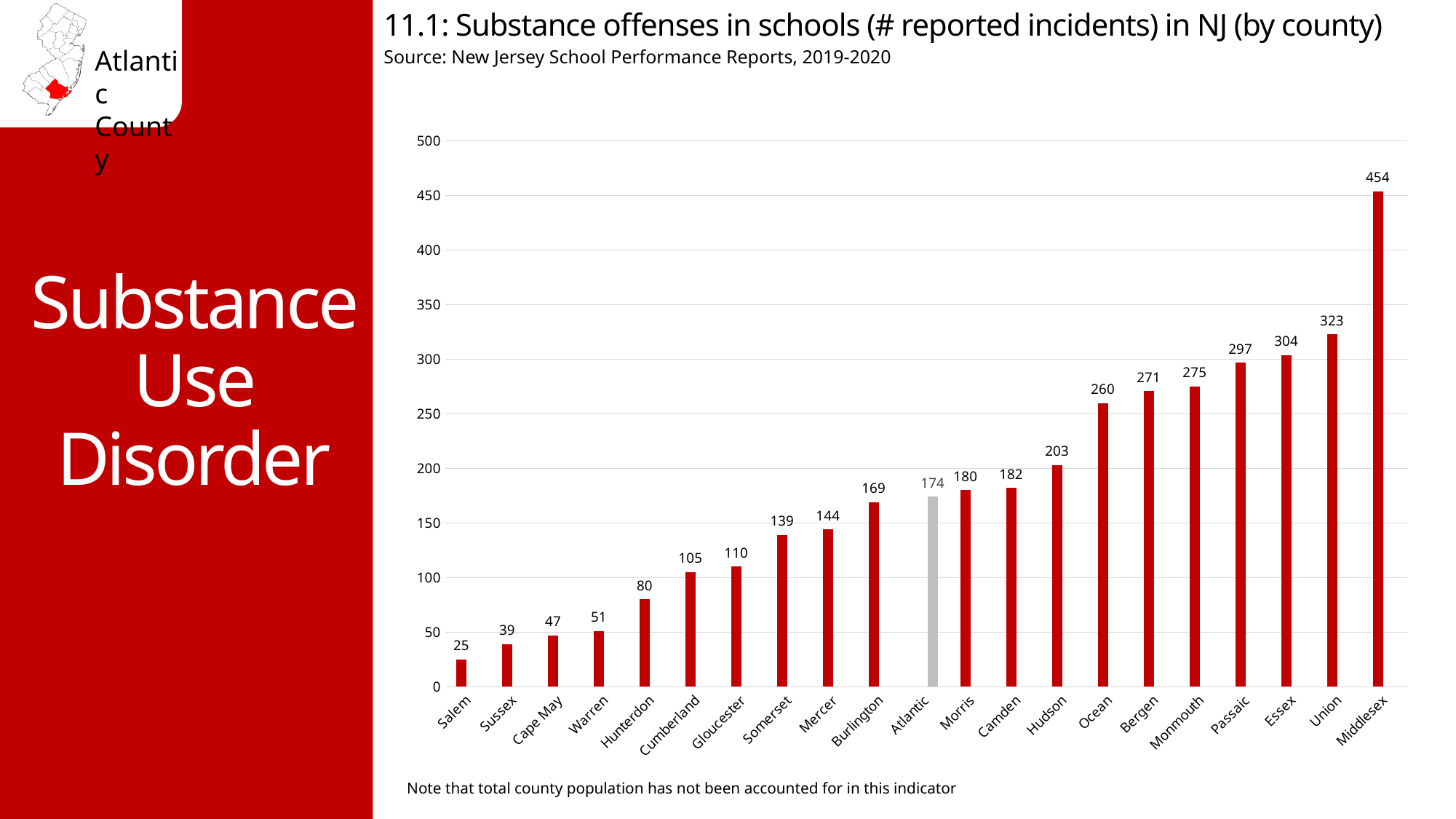
What is the value shown for Middlesex County? 454 How many reported incidents are shown for Hunterdon County? 80 What is the difference between the values for Atlantic and Salem? 149 Which county has the highest number of reported substance offenses in schools? Middlesex What type of chart is shown on the slide? Bar chart Which county has a larger value, Ocean or Hudson? Ocean Which county has the lowest number of reported substance offenses in schools? Salem Which county's bar is coloured grey instead of red? Atlantic How many counties are shown on the x axis of the chart? 21 Do the values rise or fall moving from left to right along the x axis? Rise What is the difference between the values for Middlesex and Union? 131 What is the number of reported substance offense incidents in schools for Atlantic County? 174